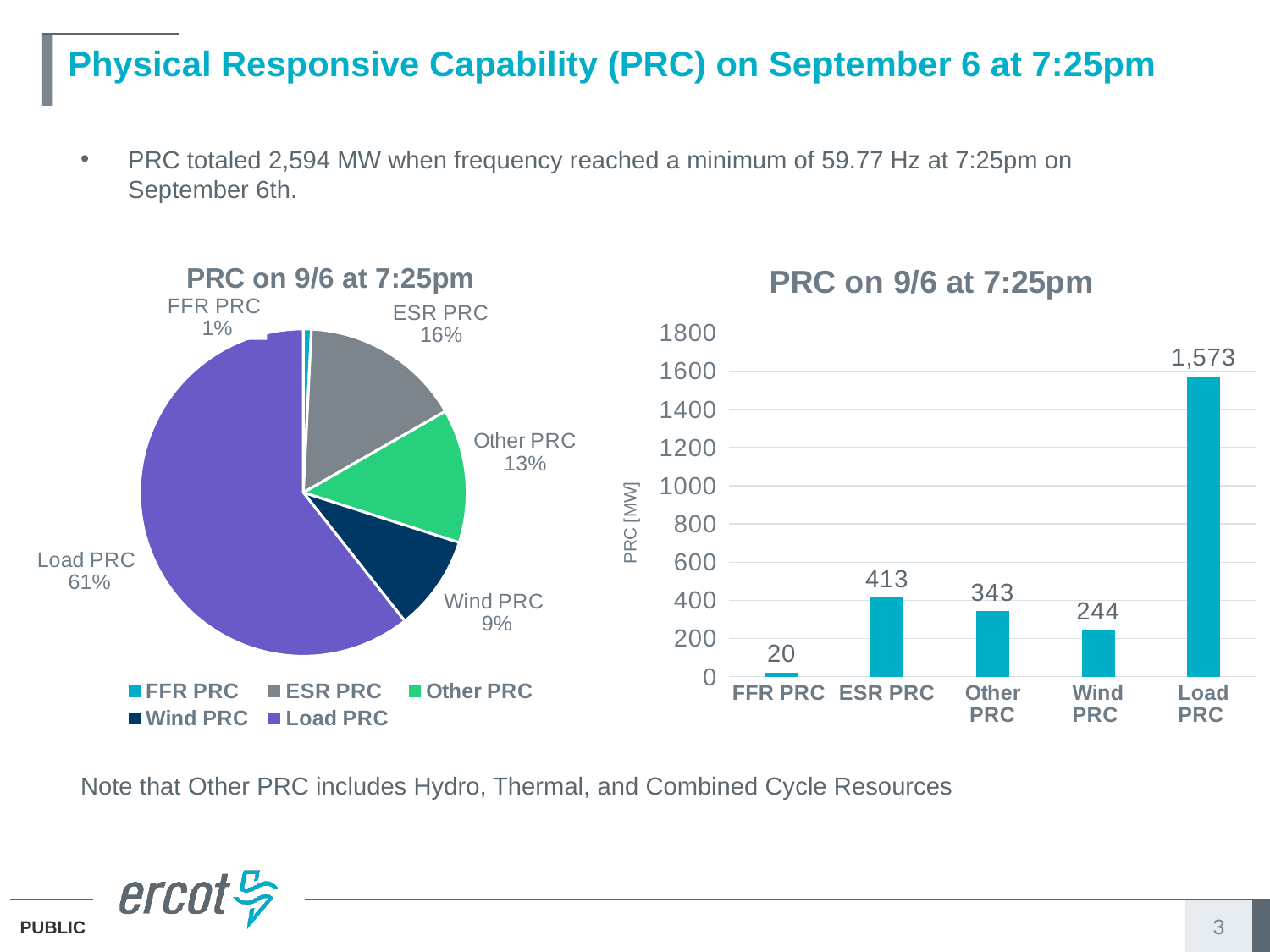
In the bar chart on the right, what is the y-axis label? PRC [MW] In the bar chart on the right, what is the value for Wind PRC? 244 In the bar chart on the right, what is the value for ESR PRC? 413 In the bar chart on the right, which is larger, Other PRC or Wind PRC? Other PRC In the bar chart on the right, what is the value for Load PRC? 1,573 In the bar chart on the right, which category has the highest value? Load PRC In the pie chart on the left, what share does Load PRC have? 61% In the bar chart on the right, how many categories are shown? 5 In the pie chart on the left, what share does ESR PRC have? 16% What kind of chart is the chart on the left? Pie chart In the bar chart on the right, which category has the lowest value? FFR PRC In the bar chart on the right, what is the difference between ESR PRC and Other PRC? 70